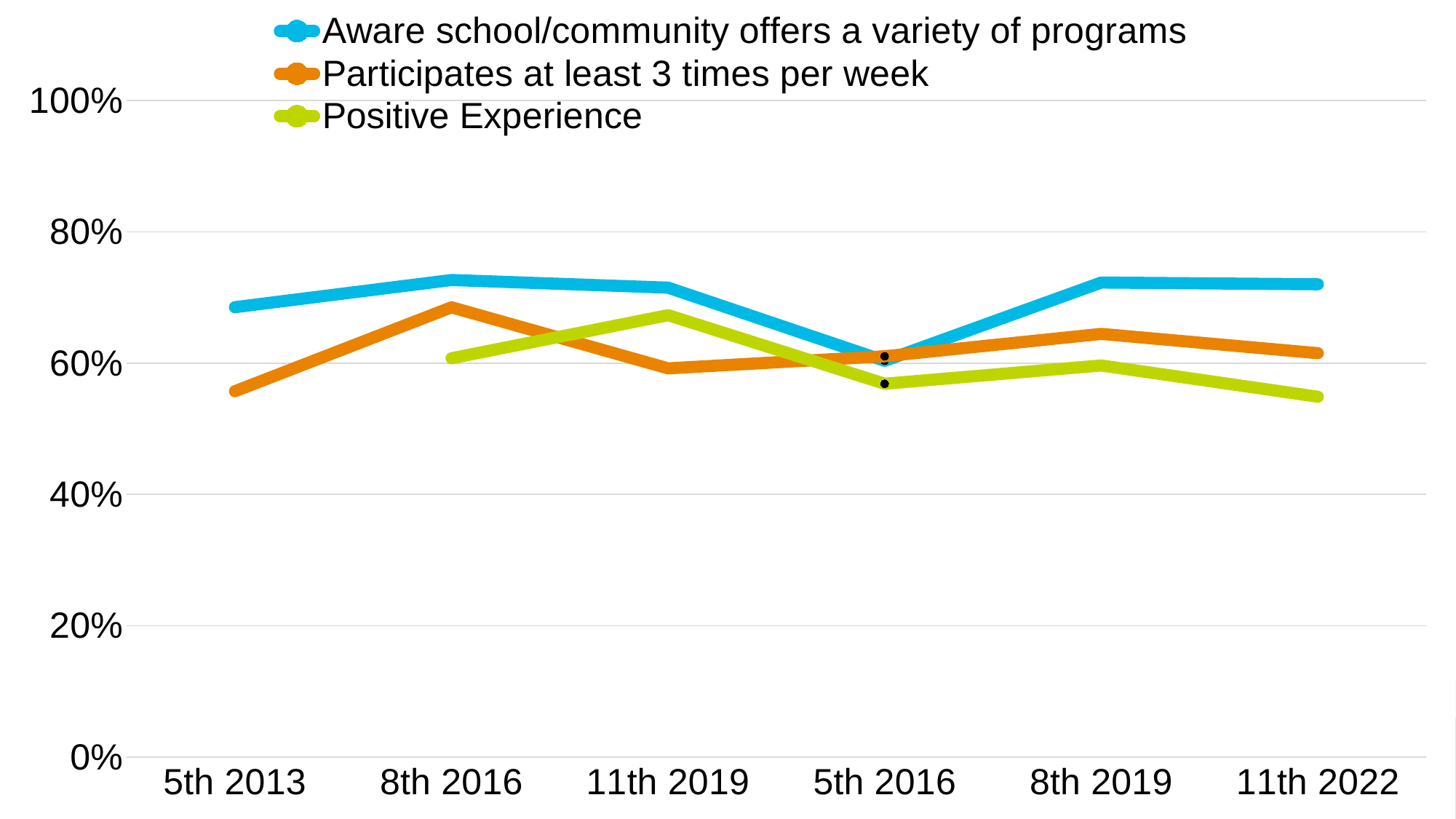
Is the value for 'Positive Experience' at 11th 2022 greater or less than 60%? less What kind of chart is shown on the slide? line chart Is the value for 'Aware school/community offers a variety of programs' at 5th 2013 greater or less than 60%? greater How many series does the legend list? 3 At which category does 'Participates at least 3 times per week' reach its highest value? 8th 2016 At which category does 'Aware school/community offers a variety of programs' have its lowest value? 5th 2016 Is the value for 'Participates at least 3 times per week' at 5th 2013 greater or less than 60%? less At 5th 2013, which series has the higher value: 'Aware school/community offers a variety of programs' or 'Participates at least 3 times per week'? Aware school/community offers a variety of programs Which series has no data point at 5th 2013? Positive Experience How many categories are shown on the x axis? 6 At which category does 'Positive Experience' reach its highest value? 11th 2019